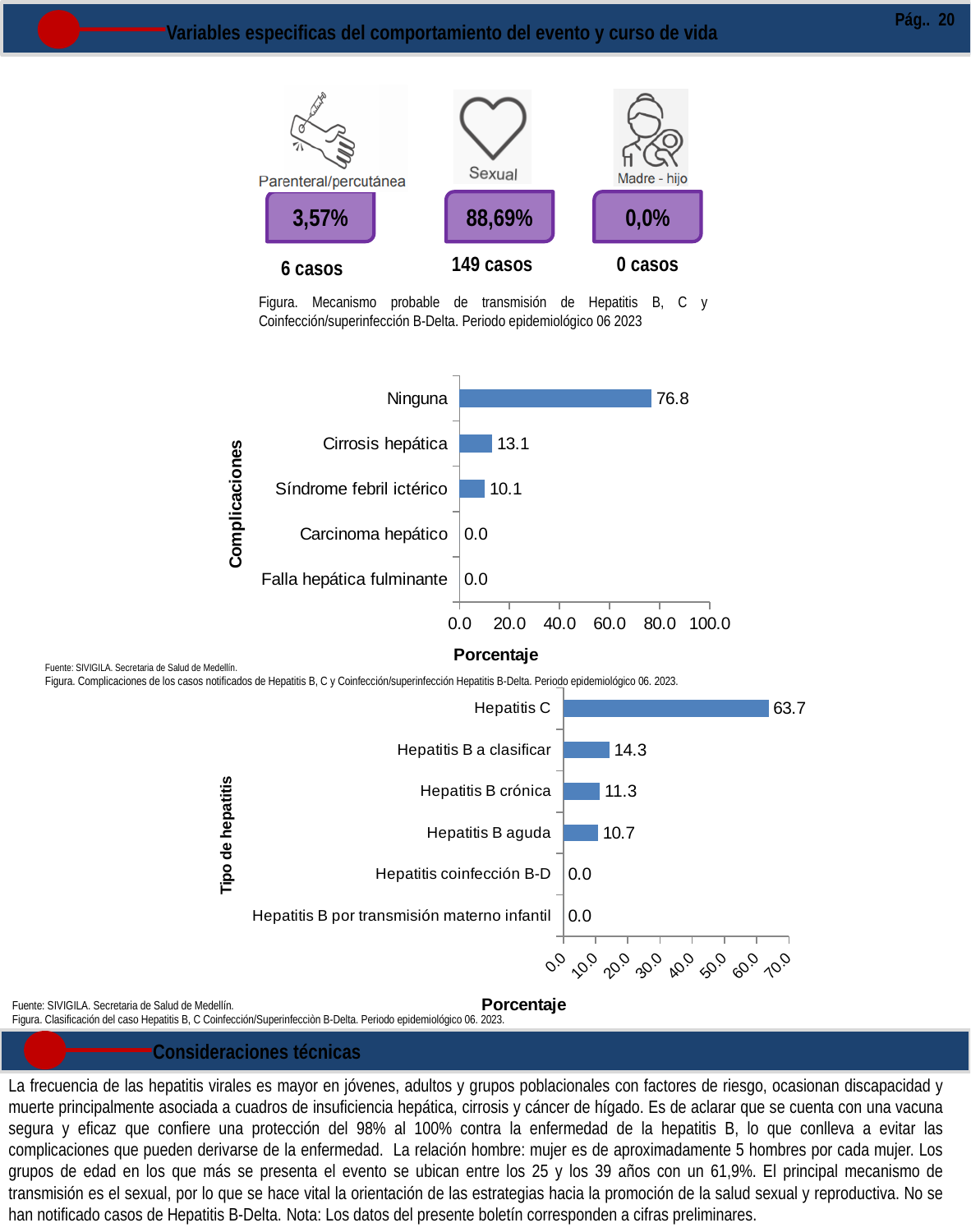
In the lower bar chart (Tipo de hepatitis), what is the difference between the percentages for Hepatitis C and Hepatitis B a clasificar? 49.4 In the upper bar chart (Complicaciones), how many complication categories are shown? 5 In the lower bar chart (Tipo de hepatitis), how many hepatitis type categories are shown? 6 What type of chart is the lower chart (Tipo de hepatitis)? Bar chart In the lower bar chart (Tipo de hepatitis), which is larger, Hepatitis B a clasificar or Hepatitis B crónica? Hepatitis B a clasificar In the upper bar chart (Complicaciones), is the value for Ninguna greater or less than 60.0? greater In the upper bar chart (Complicaciones), what is the difference between the percentages for Cirrosis hepática and Síndrome febril ictérico? 3.0 In the lower bar chart (Tipo de hepatitis), what is the percentage for Hepatitis C? 63.7 In the lower bar chart (Tipo de hepatitis), what is the percentage for Hepatitis B aguda? 10.7 In the upper bar chart (Complicaciones), which complication has the highest percentage? Ninguna In the upper bar chart (Complicaciones), what is the percentage for Cirrosis hepática? 13.1 In the upper bar chart (Complicaciones), what is the percentage for Ninguna? 76.8